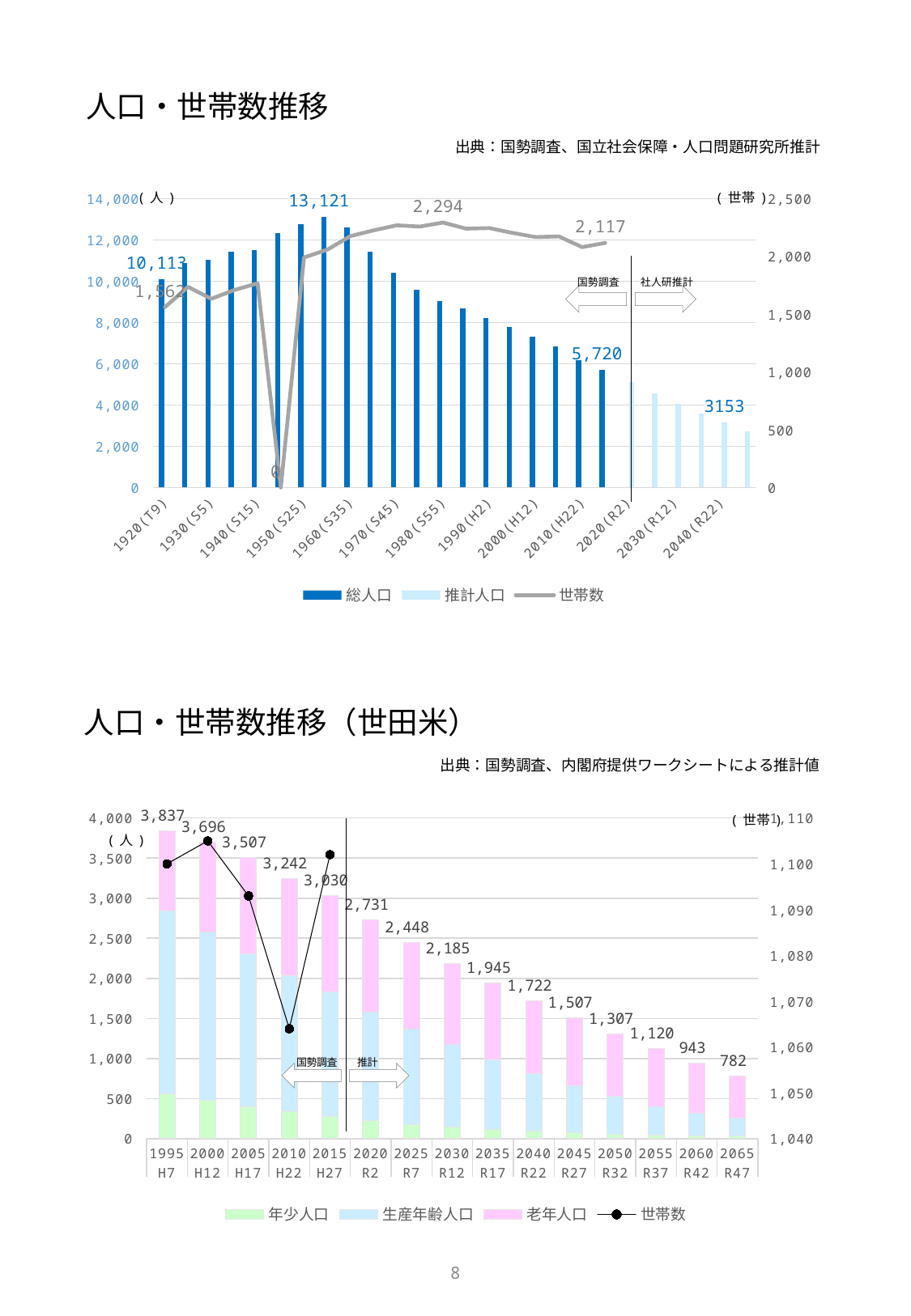
In the bottom chart titled 人口・世帯数推移（世田米）, which year has the highest labelled total? 1995 H7 In the top chart titled 人口・世帯数推移, is the 総人口 value for 2000(H12) greater or less than 8,000? less In the bottom chart titled 人口・世帯数推移（世田米）, what is the labelled total for 1995 H7? 3,837 In the top chart titled 人口・世帯数推移, how many series does the legend list? 3 In the bottom chart titled 人口・世帯数推移（世田米）, do the labelled totals rise or fall from 1995 to 2065? fall In the bottom chart titled 人口・世帯数推移（世田米）, what is the difference between the labelled totals for 2020 R2 and 2025 R7? 283 In the top chart titled 人口・世帯数推移, what is the labelled value of 推計人口 for 2040(R22)? 3153 In the bottom chart titled 人口・世帯数推移（世田米）, how many year categories are shown on the x axis? 15 In the bottom chart titled 人口・世帯数推移（世田米）, what is the labelled total for 2065 R47? 782